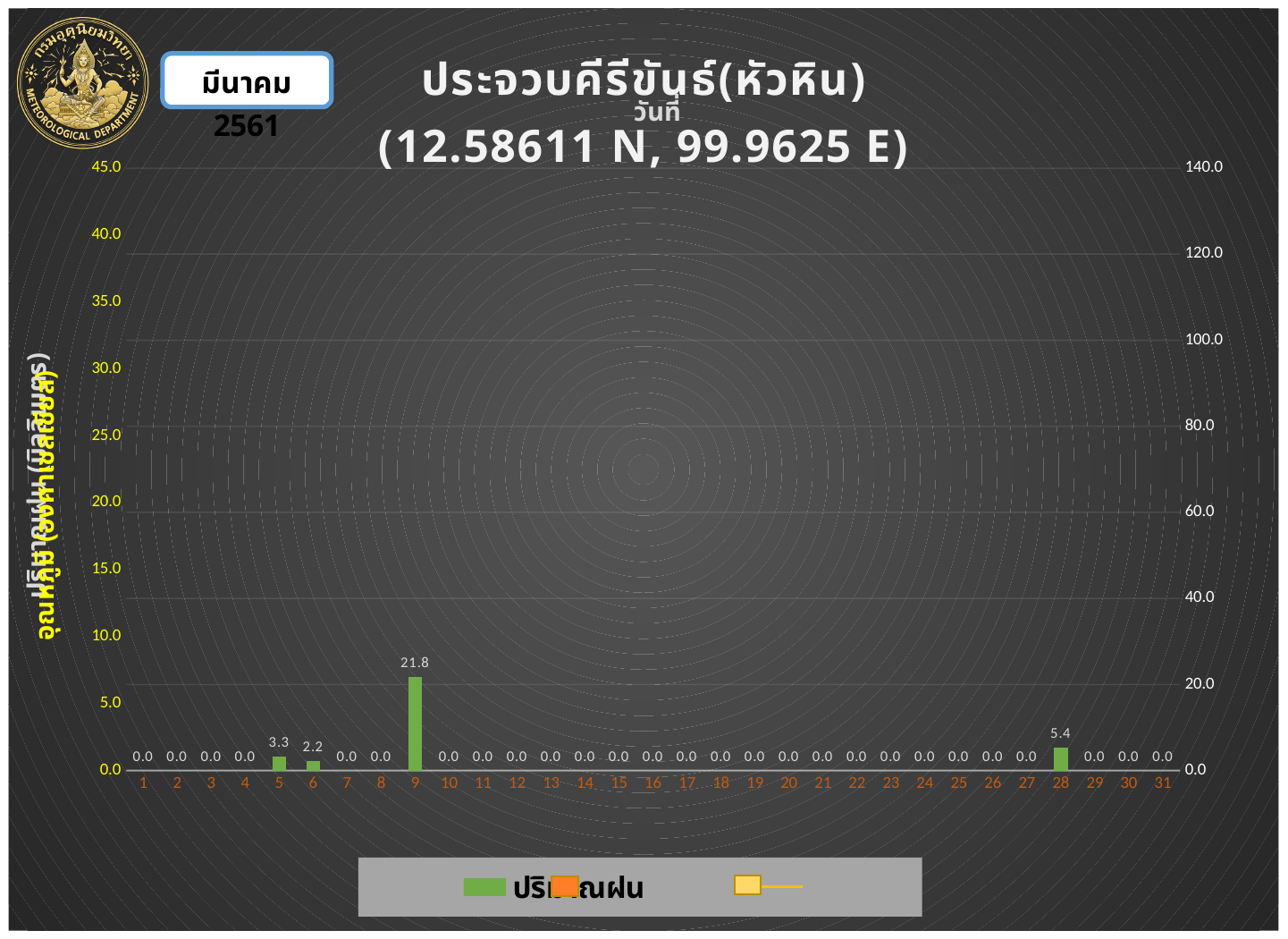
Which is larger, the rainfall value for day 5 or for day 28? day 28 What is the rainfall value shown for day 15? 0.0 What coordinates are given in the chart title? 12.58611 N, 99.9625 E What is the rainfall value shown for day 6? 2.2 Which day has the highest rainfall value? 9 What is the difference between the rainfall values for day 5 and day 6? 1.1 What is the rainfall value shown for day 28? 5.4 What is the rainfall value shown for day 9? 21.8 How many days are shown on the x axis? 31 What kind of chart is shown on the slide? bar chart What is the rainfall value shown for day 5? 3.3 What is the difference between the rainfall values for day 9 and day 28? 16.4